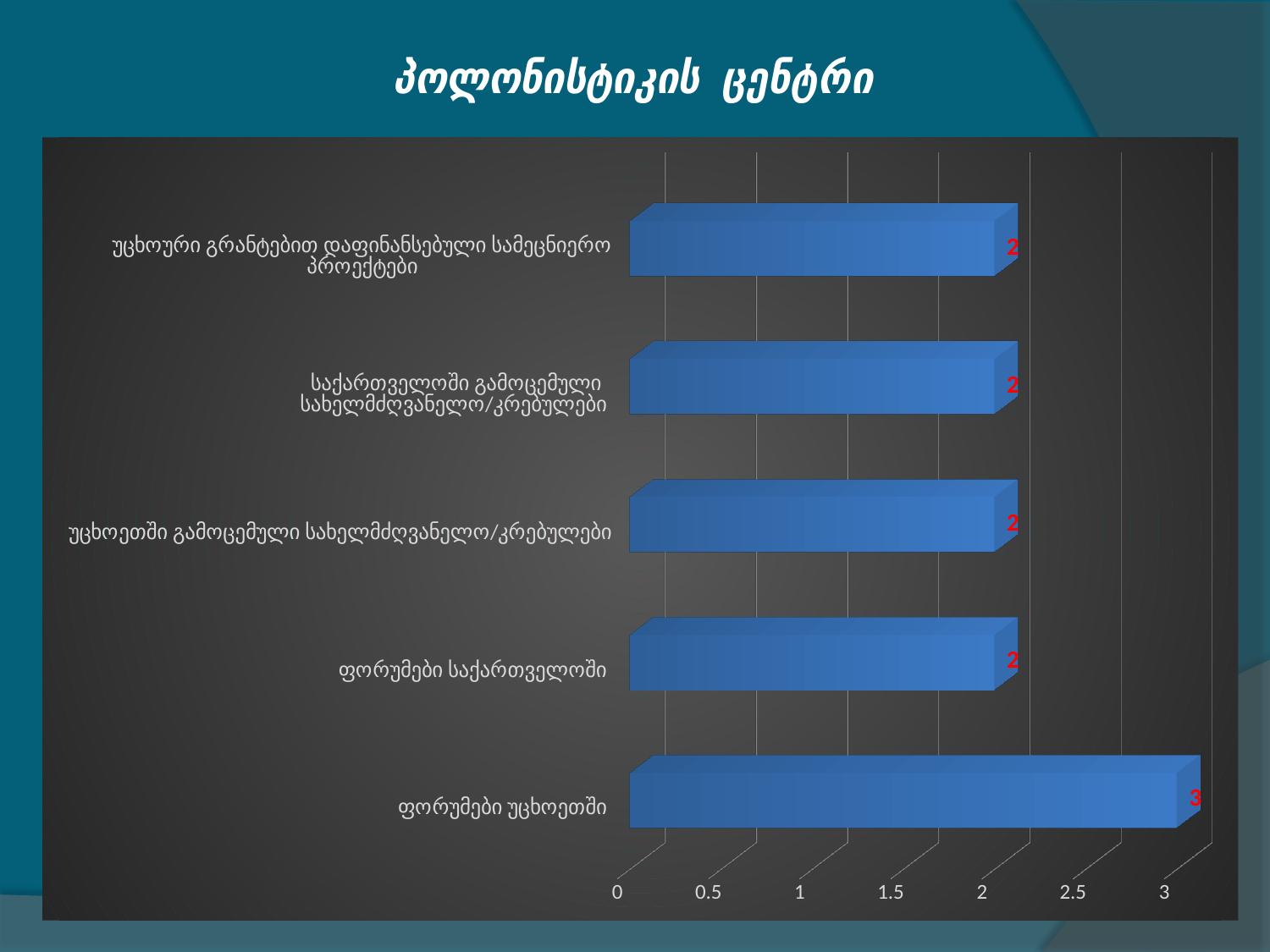
How many categories are shown in the chart? 5 What is the title of the slide? პოლონისტიკის ცენტრი What is the value for უცხოეთში გამოცემული სახელმძღვანელო/კრებულები? 2 Which category has the highest value? ფორუმები უცხოეთში Which is larger: the value for ფორუმები უცხოეთში or the value for საქართველოში გამოცემული სახელმძღვანელო/კრებულები? ფორუმები უცხოეთში What is the value for ფორუმები საქართველოში? 2 What is the value for ფორუმები უცხოეთში? 3 What is the difference between the values for ფორუმები უცხოეთში and ფორუმები საქართველოში? 1 Is the value for ფორუმები უცხოეთში greater or less than 2.5? greater What kind of chart is shown on the slide? bar chart What is the value for უცხოური გრანტებით დაფინანსებული სამეცნიერო პროექტები? 2 Is the value for ფორუმები საქართველოში greater or less than 2.5? less